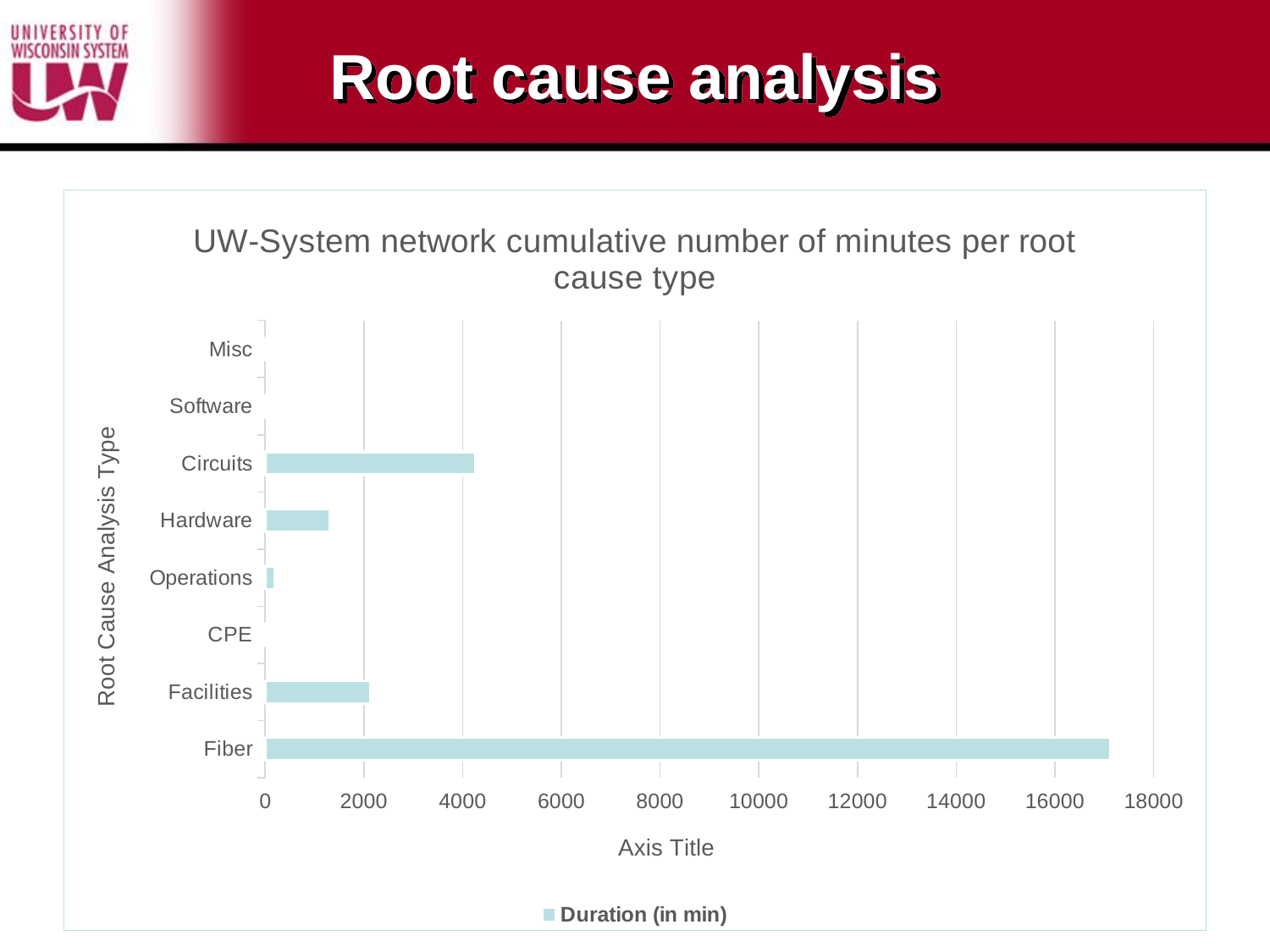
Is the value for Hardware greater or less than 2000? less What is the title of the chart? UW-System network cumulative number of minutes per root cause type Is the value for Circuits greater or less than 6000? less Which has a larger value, Circuits or Facilities? Circuits Which has a larger value, Hardware or Facilities? Facilities What kind of chart is shown on the slide? bar chart Is the value for Facilities greater or less than 4000? less What is the legend entry for the plotted series? Duration (in min) How many series does the legend list? 1 How many root cause categories are listed on the vertical axis? 8 Which root cause type has the highest cumulative number of minutes? Fiber